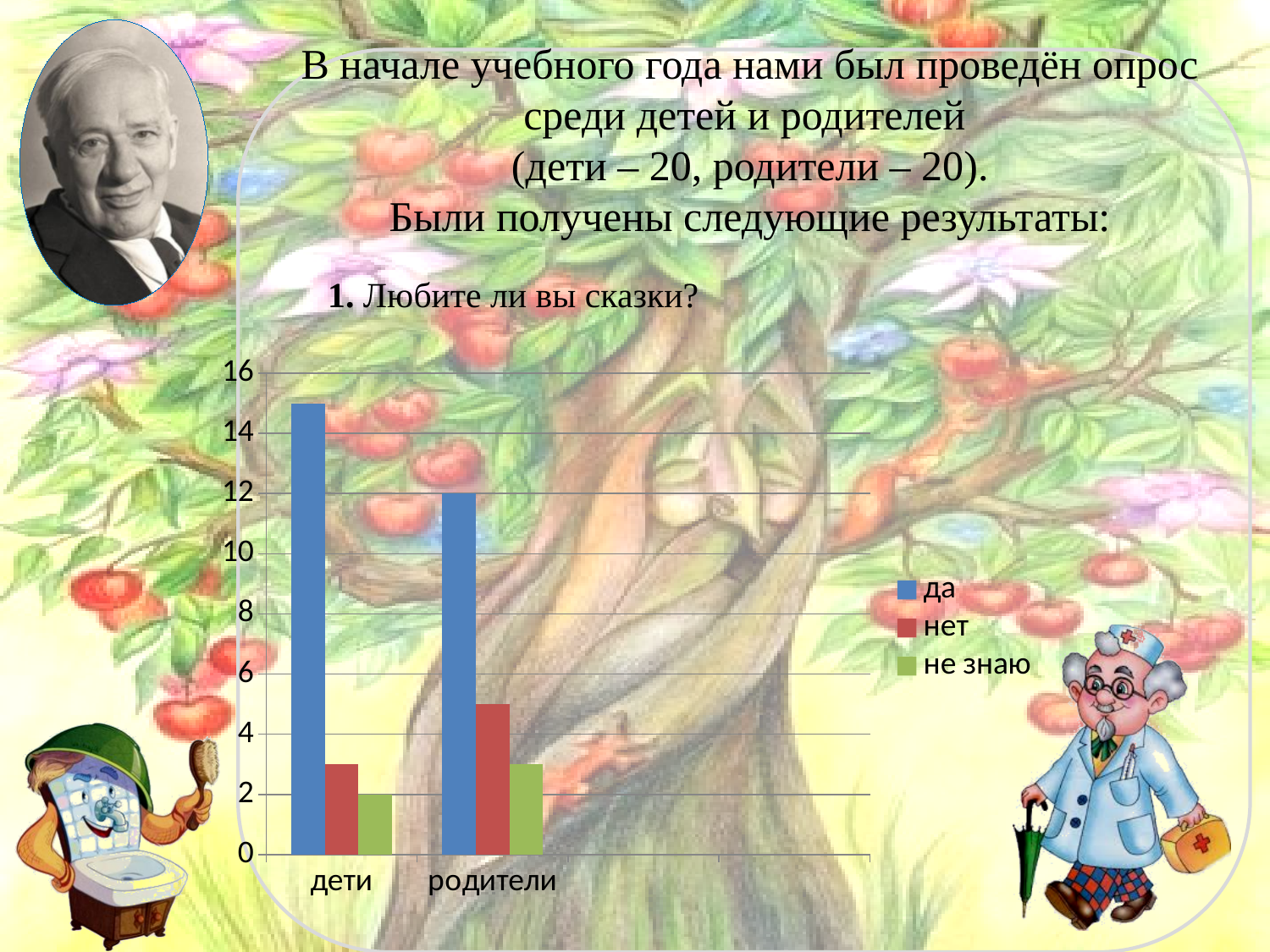
Which series has the highest value for "дети"? да Is the value of "да" for "дети" greater or less than 14? greater Which category has the larger value for "да": "дети" or "родители"? дети How many series does the legend list? 3 What kind of chart is shown on the slide? bar chart Which series has the lowest value for "дети"? не знаю How many categories are shown on the x axis? 2 Is the value of "нет" for "родители" greater or less than 4? greater What question does the chart present results for? Любите ли вы сказки? What is the value of "не знаю" for "дети"? 2 What is the value of "да" for "родители"? 12 Which category has the larger value for "нет": "дети" or "родители"? родители